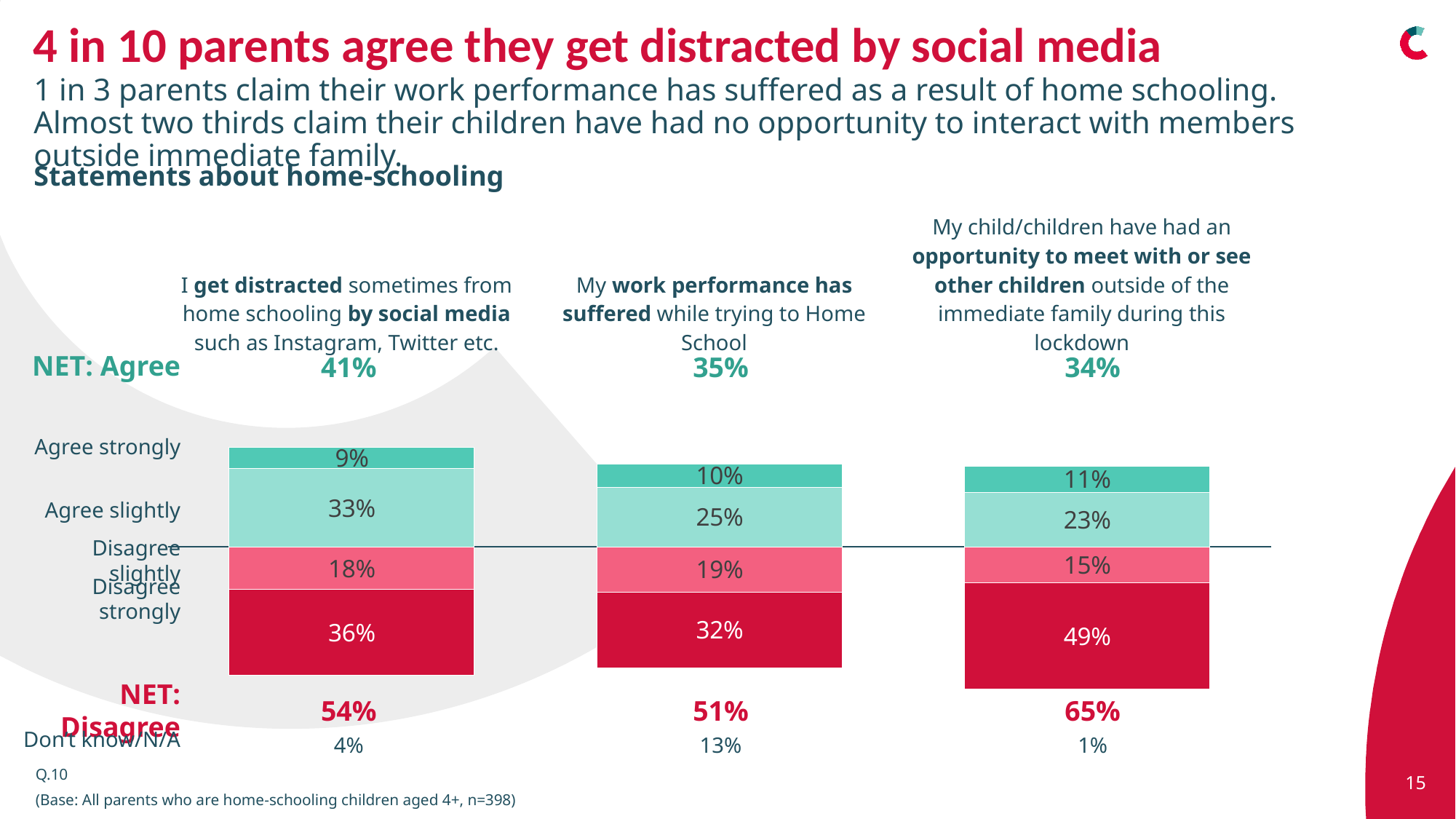
How many statements about home-schooling are shown in the chart? 3 What percentage of parents disagree strongly that their work performance has suffered while trying to home school? 32% What is the title of the chart? Statements about home-schooling Which is larger: the Disagree strongly share for the social media distraction statement or for the work performance statement? Social media distraction statement (36%) What is the Don't know/N/A percentage for the statement about work performance having suffered? 13% What percentage of parents agree strongly that they get distracted sometimes from home schooling by social media? 9% What is the NET: Agree figure for the statement that children have had an opportunity to meet with or see other children outside the immediate family? 34% What kind of chart is shown on the slide? Stacked bar chart Which statement has the highest NET: Disagree percentage? My child/children have had an opportunity to meet with or see other children outside of the immediate family during this lockdown How many response categories make up each stacked bar? 4 What is the difference between the NET: Agree for the social media distraction statement and the NET: Agree for the work performance statement? 6% Which statement has the lowest Agree slightly percentage? My child/children have had an opportunity to meet with or see other children outside of the immediate family during this lockdown